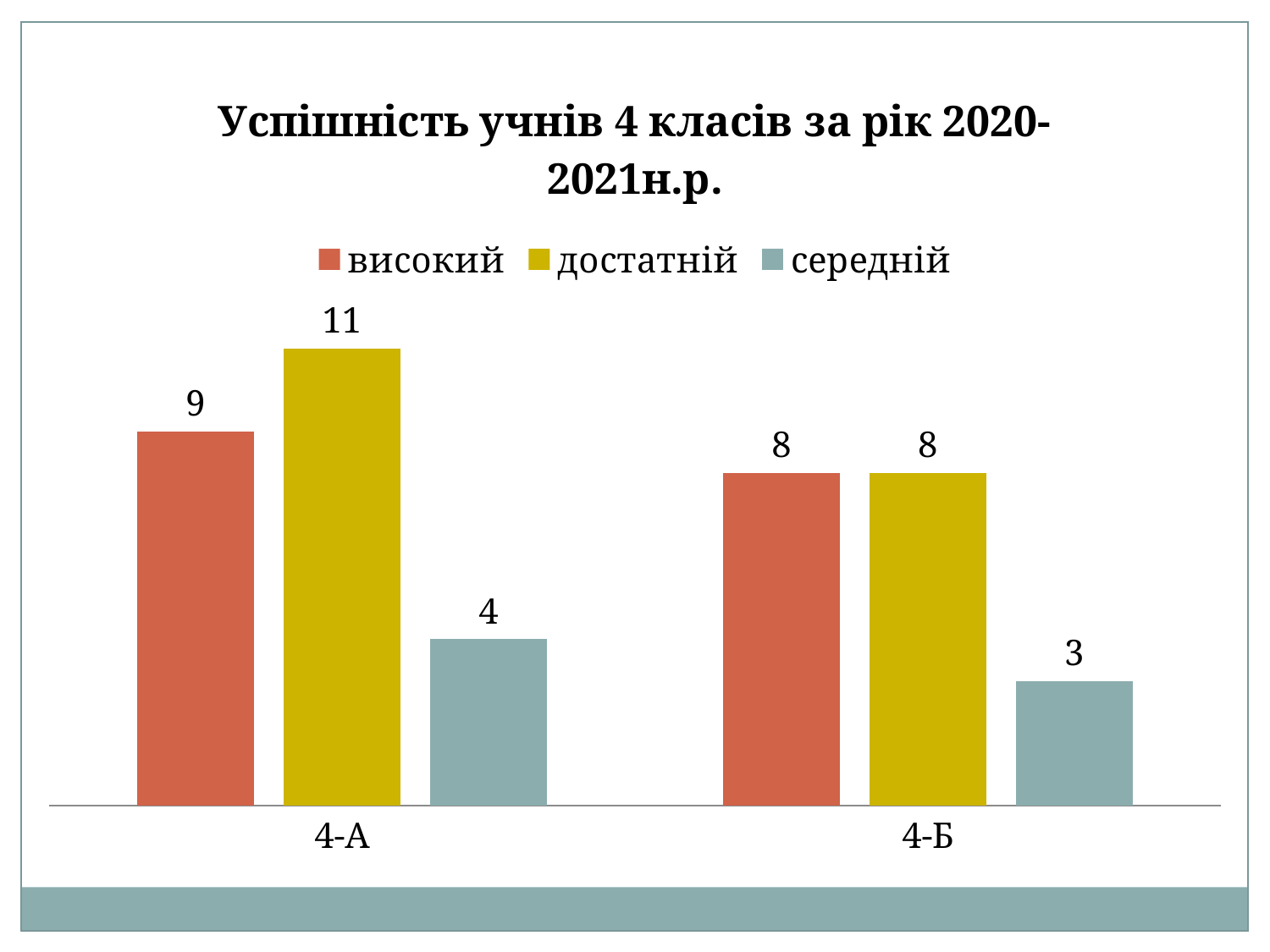
Which series has the lowest value in class 4-Б? середній What is the value for "достатній" in class 4-А? 11 What kind of chart is shown on the slide? bar chart What is the value for "високий" in class 4-А? 9 What is the value for "середній" in class 4-Б? 3 Which is larger: "середній" in 4-А or "середній" in 4-Б? 4-А What is the title of the chart? Успішність учнів 4 класів за рік 2020-2021н.р. How many classes (categories) are shown on the x axis? 2 What is the difference between "достатній" and "середній" in class 4-А? 7 Which series has the highest value in class 4-А? достатній What is the value for "високий" in class 4-Б? 8 How many series does the legend list? 3